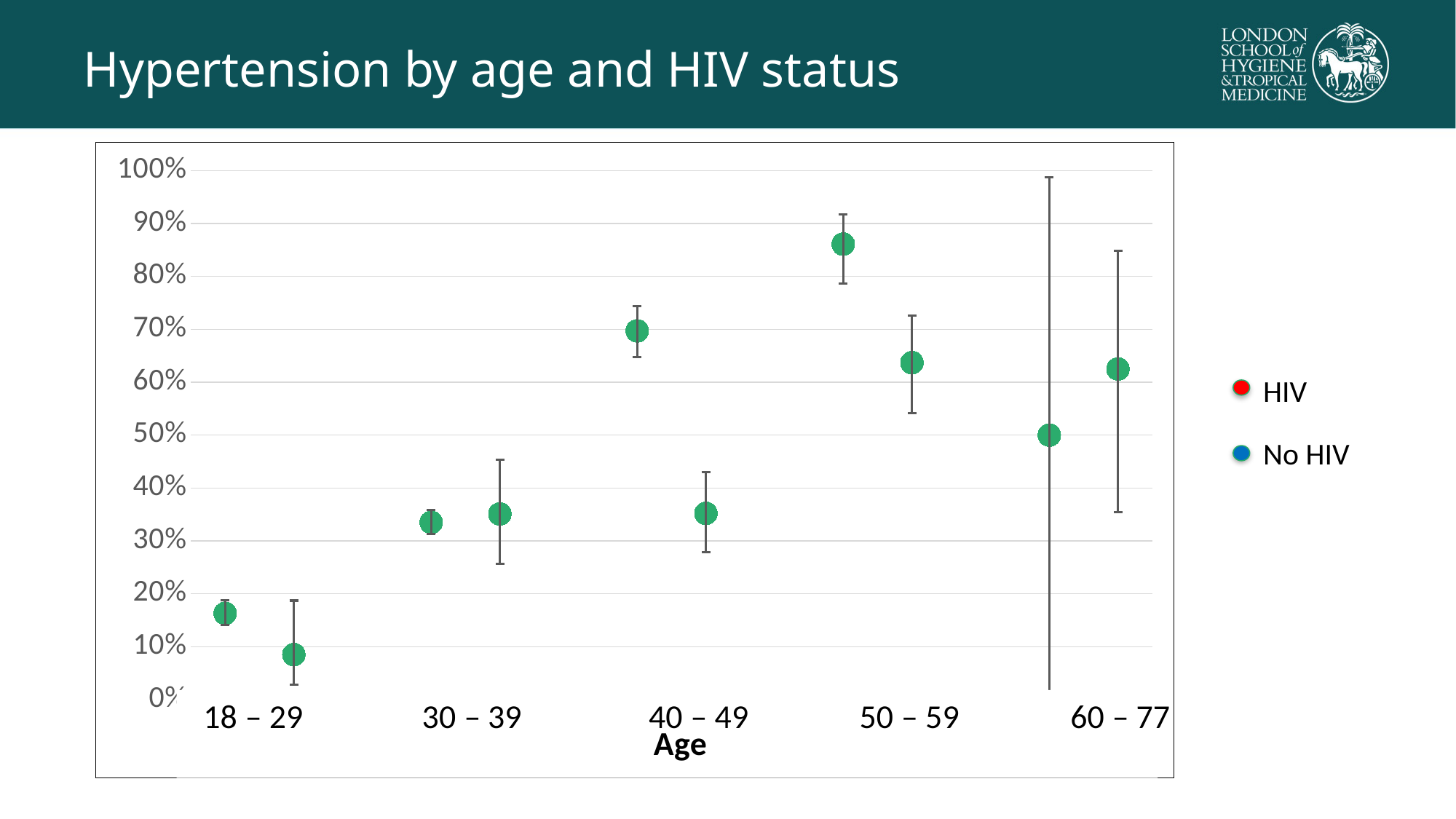
What is the label of the x axis? Age Is the value of the right-hand point in the 18 – 29 age group greater or less than 10%? less Is the value of the right-hand point in the 40 – 49 age group greater or less than 40%? less Which age group contains the lowest plotted point? 18 – 29 How many series does the legend list? 2 What is the title of the chart? Hypertension by age and HIV status How many age groups are shown on the x axis? 5 Within the 50 – 59 age group, is the left-hand point or the right-hand point higher? left-hand point Is the value of the left-hand point in the 50 – 59 age group greater or less than 80%? greater What kind of chart is this? Scatter (dot) chart with error bars Which age group contains the highest plotted point? 50 – 59